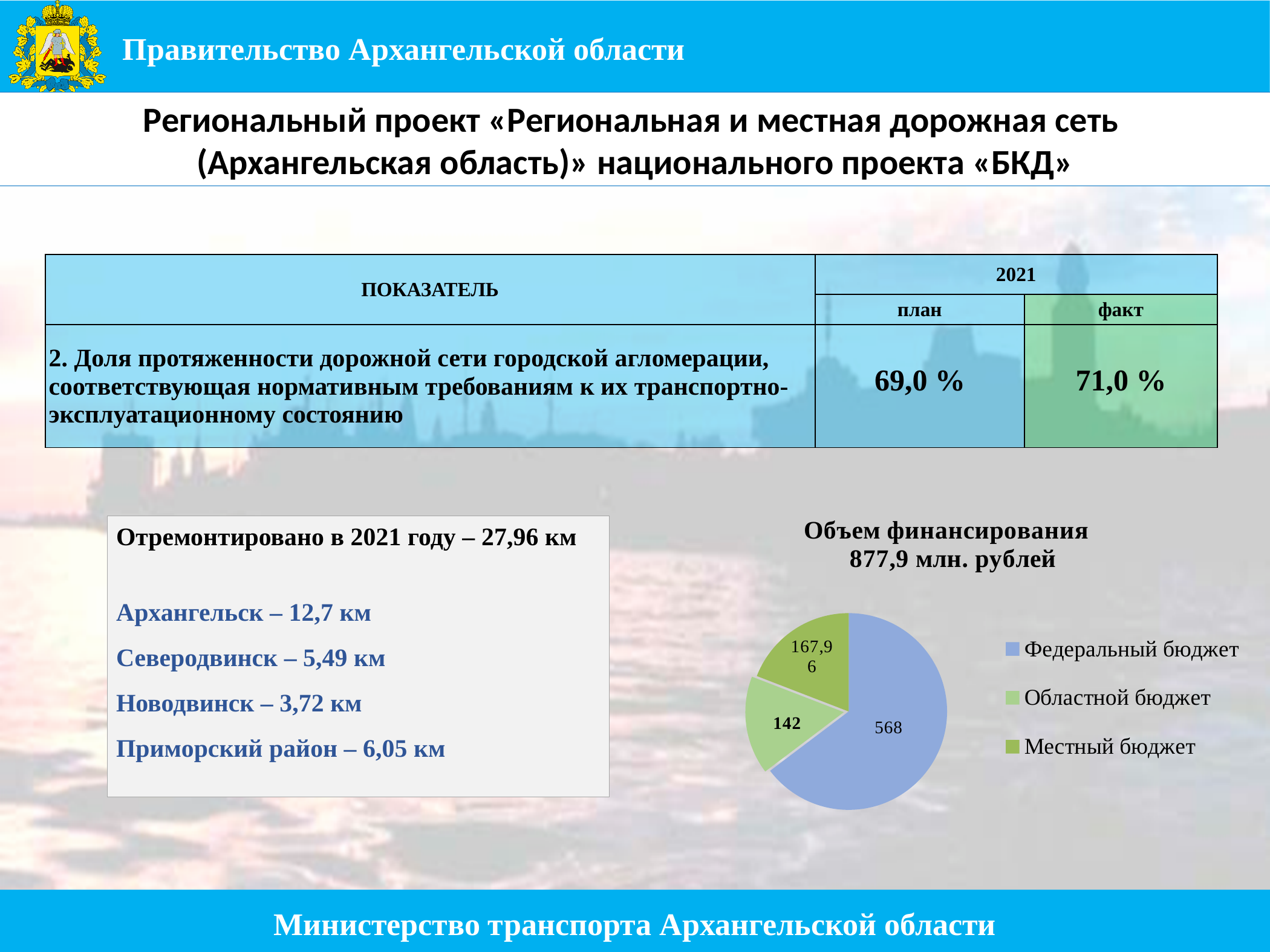
What is the difference between the Местный бюджет and Областной бюджет values in the pie chart? 25,96 Which budget source has the smallest slice in the pie chart? Областной бюджет What type of chart is shown on the slide? pie chart How many entries does the legend of the pie chart list? 3 What is the value for Областной бюджет in the pie chart? 142 What is the title of the pie chart? Объем финансирования 877,9 млн. рублей What is the value for Федеральный бюджет in the pie chart? 568 Which budget source has the largest slice in the pie chart? Федеральный бюджет Which is larger in the pie chart: Местный бюджет or Областной бюджет? Местный бюджет How many slices does the pie chart have? 3 What is the difference between the Федеральный бюджет and Областной бюджет values in the pie chart? 426 What is the value for Местный бюджет in the pie chart? 167,96